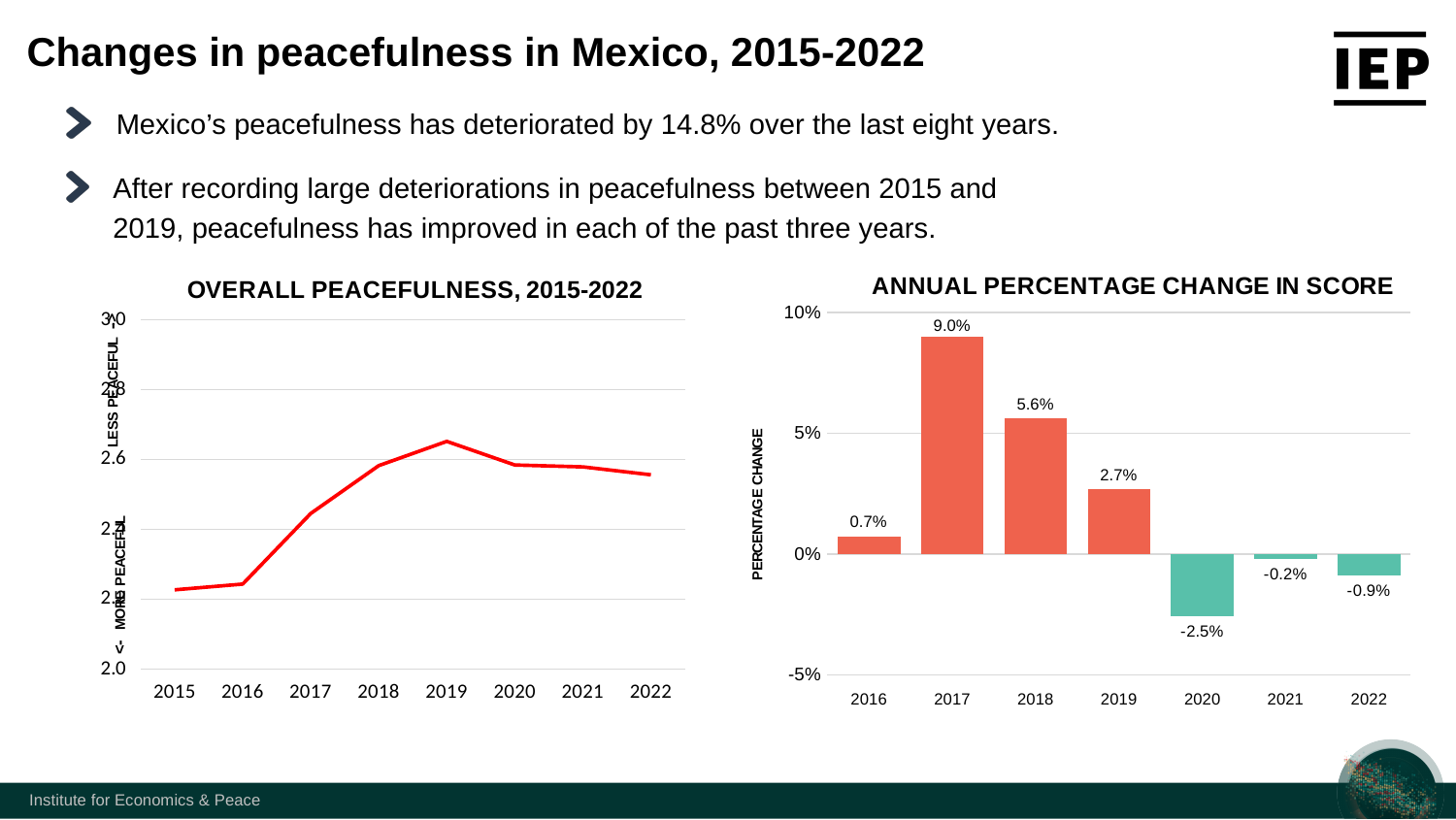
How many years are shown in the chart titled 'ANNUAL PERCENTAGE CHANGE IN SCORE'? 7 In the chart titled 'OVERALL PEACEFULNESS, 2015-2022', is the value for 2015 greater or less than 2.4? less In the chart titled 'OVERALL PEACEFULNESS, 2015-2022', is the value for 2019 greater or less than 2.6? greater In the chart titled 'ANNUAL PERCENTAGE CHANGE IN SCORE', which is larger, the value for 2016 or the value for 2019? 2019 In the chart titled 'ANNUAL PERCENTAGE CHANGE IN SCORE', which year has the highest value? 2017 What kind of chart is the chart titled 'ANNUAL PERCENTAGE CHANGE IN SCORE'? Bar chart In the chart titled 'ANNUAL PERCENTAGE CHANGE IN SCORE', what is the value for 2020? -2.5% In the chart titled 'ANNUAL PERCENTAGE CHANGE IN SCORE', what is the value for 2017? 9.0% In the chart titled 'ANNUAL PERCENTAGE CHANGE IN SCORE', what is the difference between the values for 2017 and 2018? 3.4 percentage points In the chart titled 'ANNUAL PERCENTAGE CHANGE IN SCORE', what is the value for 2022? -0.9% In the chart titled 'ANNUAL PERCENTAGE CHANGE IN SCORE', which year has the lowest value? 2020 What kind of chart is the chart titled 'OVERALL PEACEFULNESS, 2015-2022'? Line chart